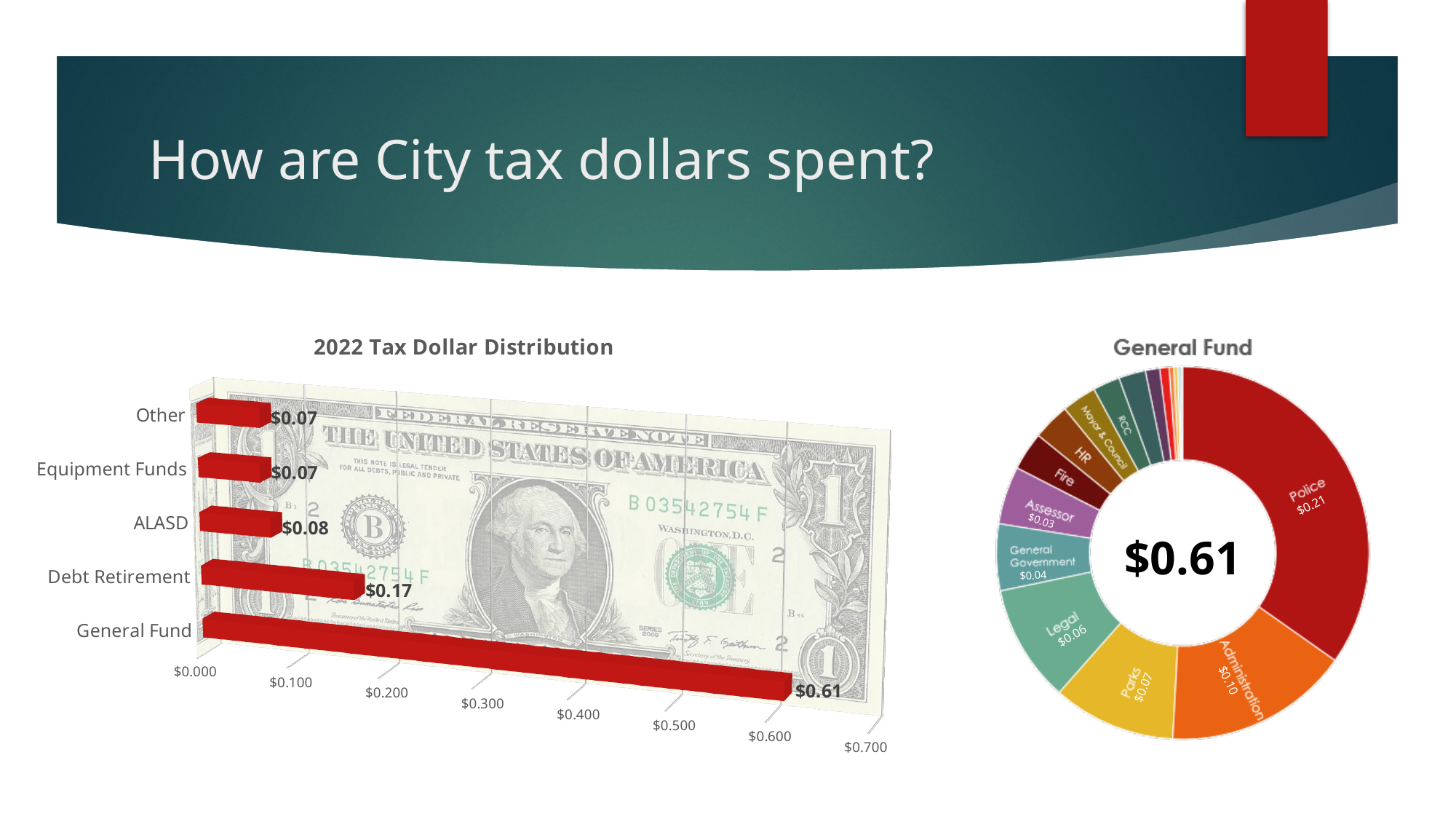
In the 2022 Tax Dollar Distribution chart, what is the value for ALASD? $0.08 In the 2022 Tax Dollar Distribution chart, what is the value for General Fund? $0.61 In the 2022 Tax Dollar Distribution chart, what is the difference between General Fund and Debt Retirement? $0.44 What kind of chart is the 2022 Tax Dollar Distribution chart? Bar chart In the General Fund chart, what is the value for Police? $0.21 In the General Fund chart, which is larger, Parks or Legal? Parks In the 2022 Tax Dollar Distribution chart, which category has the highest value? General Fund How many categories are shown in the 2022 Tax Dollar Distribution chart? 5 In the General Fund chart, what is the value for Administration? $0.10 What value is printed in the centre of the General Fund donut chart? $0.61 In the 2022 Tax Dollar Distribution chart, what is the value for Debt Retirement? $0.17 In the 2022 Tax Dollar Distribution chart, which is larger, Debt Retirement or ALASD? Debt Retirement